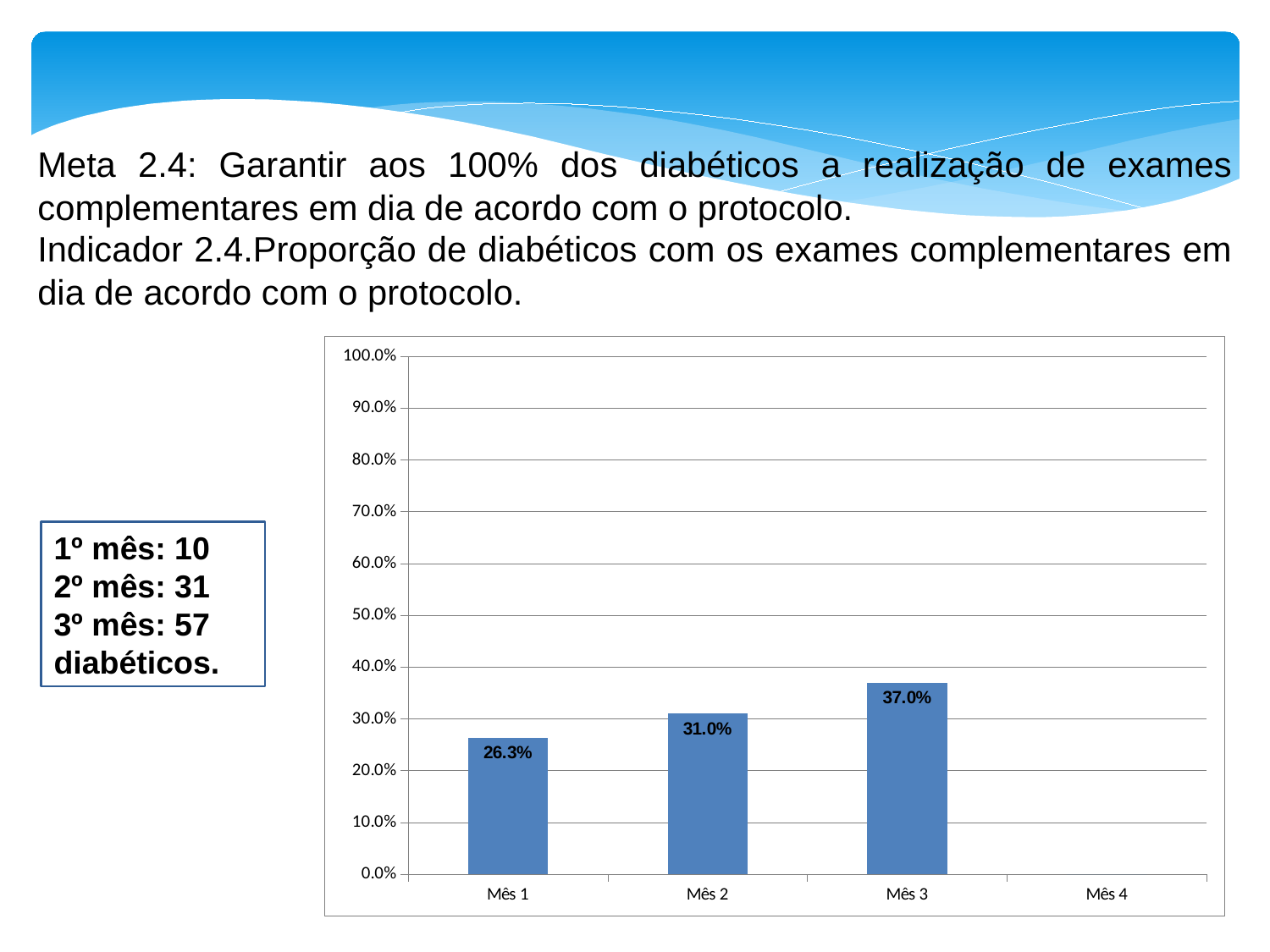
What is the value for Mês 1? 26.3% Is the value for Mês 3 greater or less than 40.0%? less What is the value for Mês 2? 31.0% What kind of chart is shown on the slide? bar chart Which month with a plotted bar has the lowest value? Mês 1 What is the difference between the values for Mês 2 and Mês 1? 4.7 percentage points How many bars are plotted in the chart? 3 Do the values rise or fall from Mês 1 to Mês 3? rise Which month has the highest value? Mês 3 Which is larger, the value for Mês 2 or the value for Mês 3? Mês 3 What is the value for Mês 3? 37.0% What is the difference between the values for Mês 3 and Mês 1? 10.7 percentage points